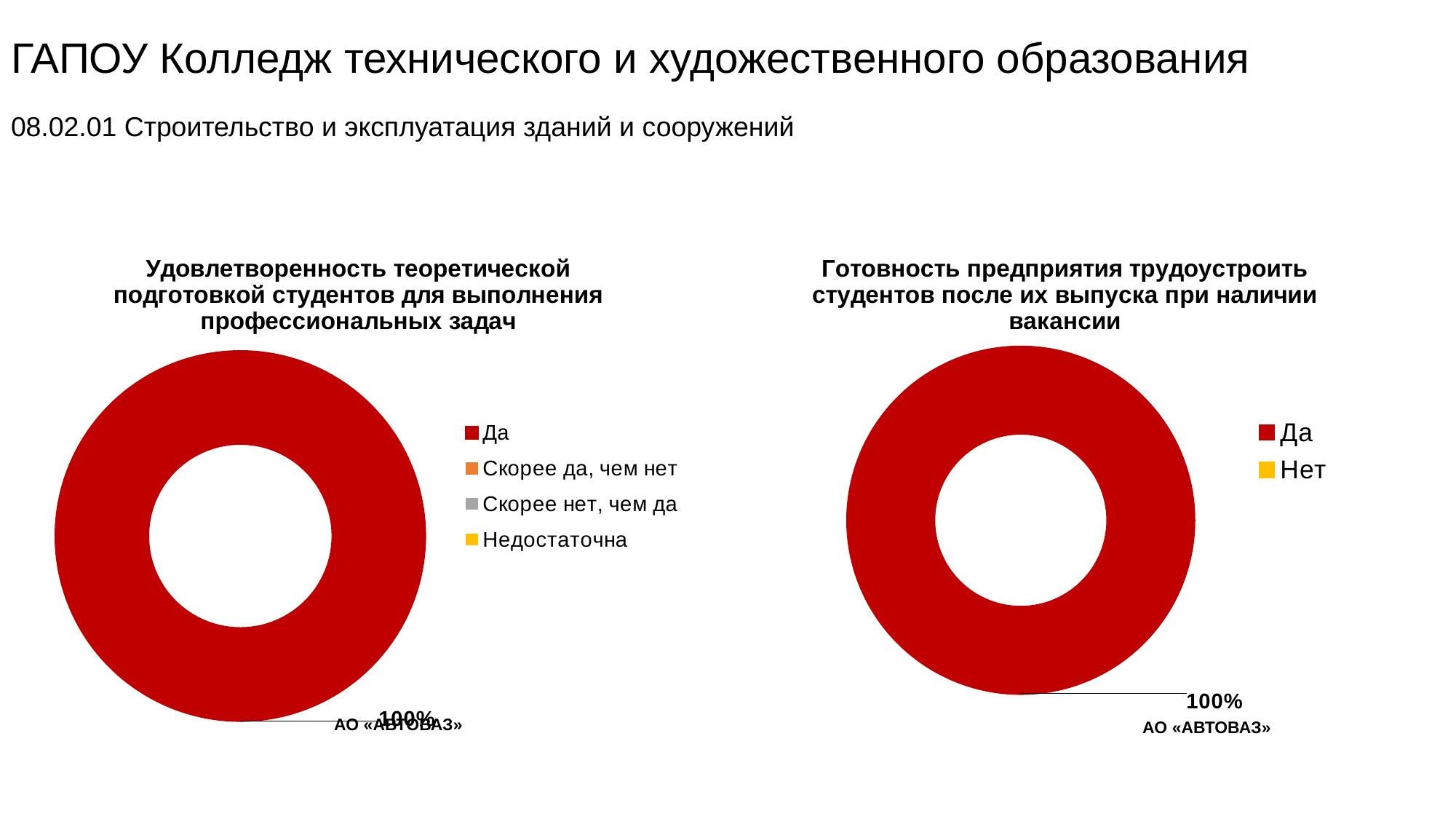
In the right chart «Готовность предприятия трудоустроить студентов...», what colour is the legend marker for «Нет»? Yellow Which enterprise is named in the data label of the right chart «Готовность предприятия трудоустроить студентов...»? АО «АВТОВАЗ» In the right chart «Готовность предприятия трудоустроить студентов...», what is the data label shown next to the ring? 100% How many entries does the legend of the left chart «Удовлетворенность теоретической подготовкой студентов...» list? 4 In the right chart «Готовность предприятия трудоустроить студентов...», which legend category is the only one visible in the ring? Да What kind of chart is the right chart titled «Готовность предприятия трудоустроить студентов после их выпуска при наличии вакансии»? Doughnut chart In the left chart «Удовлетворенность теоретической подготовкой студентов...», which legend category is the only one visible in the ring? Да How many entries does the legend of the right chart «Готовность предприятия трудоустроить студентов...» list? 2 In the left chart «Удовлетворенность теоретической подготовкой студентов...», what share of the ring does «Да» take? 100% What kind of chart is the left chart titled «Удовлетворенность теоретической подготовкой студентов для выполнения профессиональных задач»? Doughnut chart In the right chart «Готовность предприятия трудоустроить студентов...», what share of the ring does «Да» take? 100%